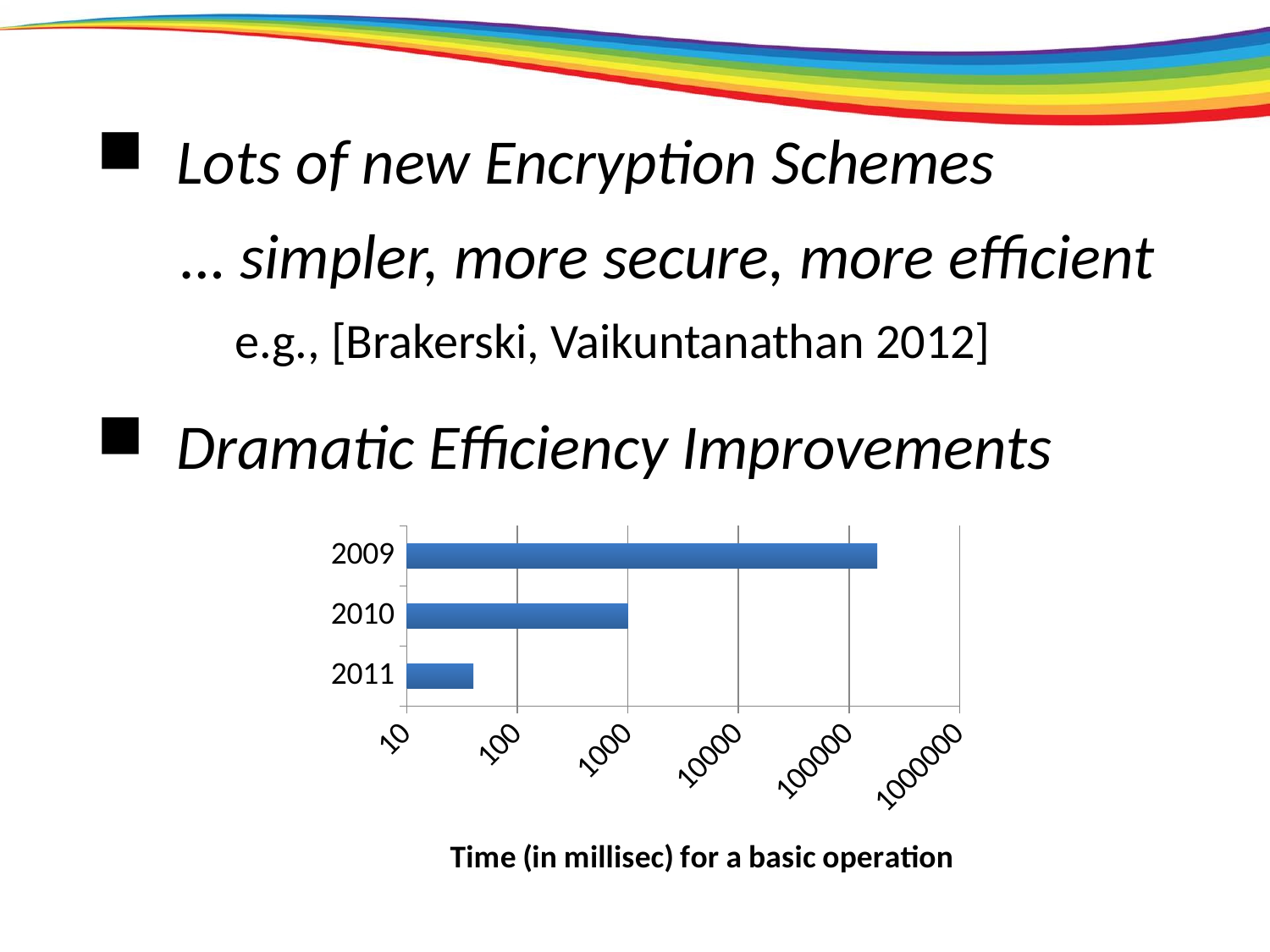
Is the value for 2009 greater or less than 1000000? less Do the values rise or fall from 2009 to 2011? fall Which year has the lowest time for a basic operation? 2011 Is the value for 2009 greater or less than 100000? greater Which year has the highest time for a basic operation? 2009 What is the largest value shown on the chart's horizontal axis? 1000000 Is the value for 2011 greater or less than 100? less What is the time (in millisec) for a basic operation in 2010? 1000 What kind of chart is shown on the slide? bar chart What is the title of the chart? Time (in millisec) for a basic operation How many categories (years) are plotted in the chart? 3 Which year has a larger value, 2010 or 2011? 2010